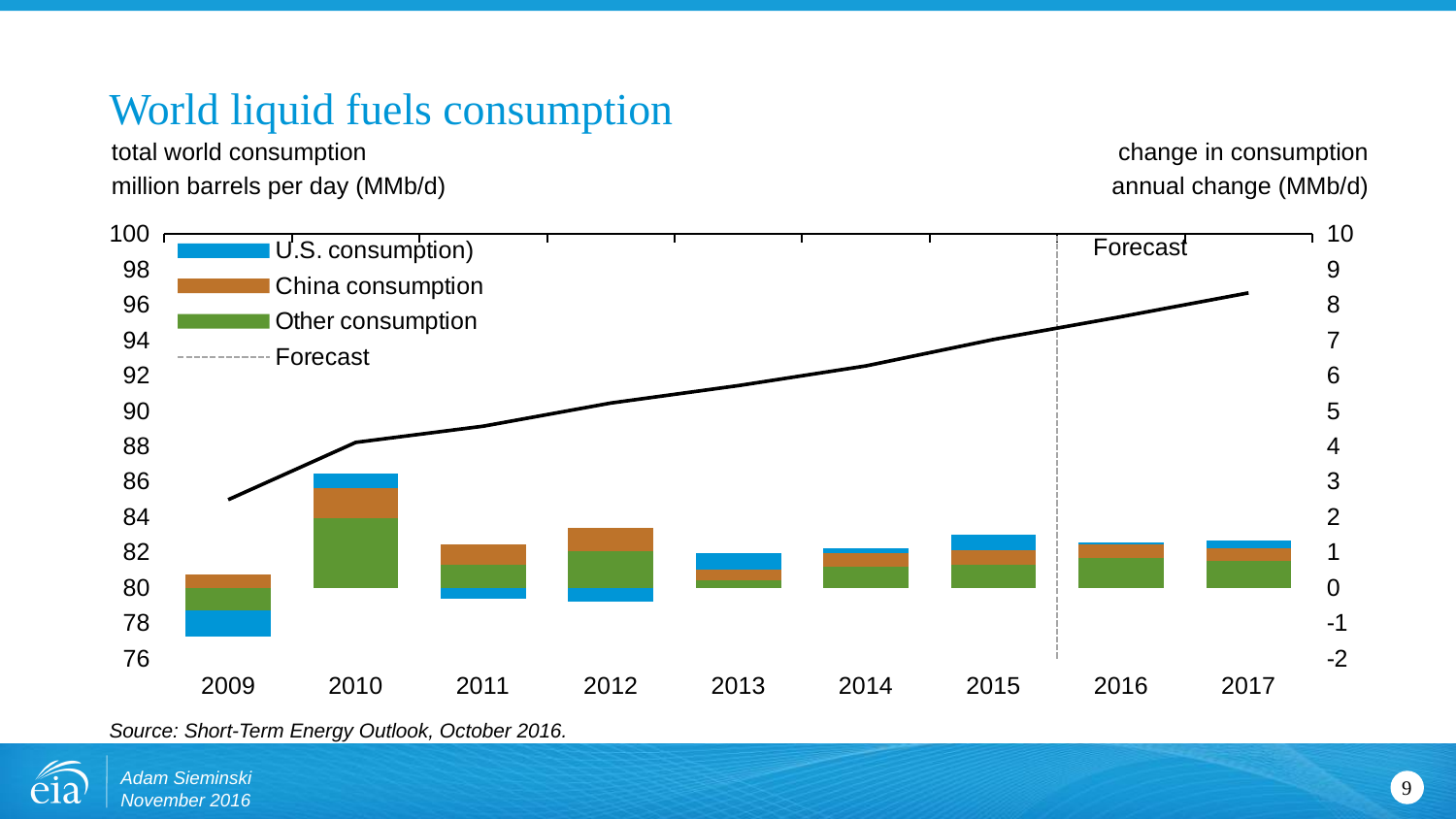
How many years are shown on the x axis? 9 What is the title of the chart? World liquid fuels consumption Which year has the largest total annual change in consumption (tallest stacked bar)? 2010 Is the total world consumption in 2009 greater or less than 86 MMb/d? less Is the total world consumption in 2017 greater or less than 94 MMb/d? greater Which years on the chart are marked as forecast? 2016 and 2017 How many entries does the legend list? 4 What kind of chart is shown on the slide? A combination chart with stacked bars and a line Does the total world consumption line rise or fall from 2009 to 2017? Rises Which year is the only one with a negative annual change in consumption? 2009 Which year has the larger total annual change in consumption, 2010 or 2011? 2010 Is the total annual change in consumption in 2010 greater or less than 2 MMb/d? greater